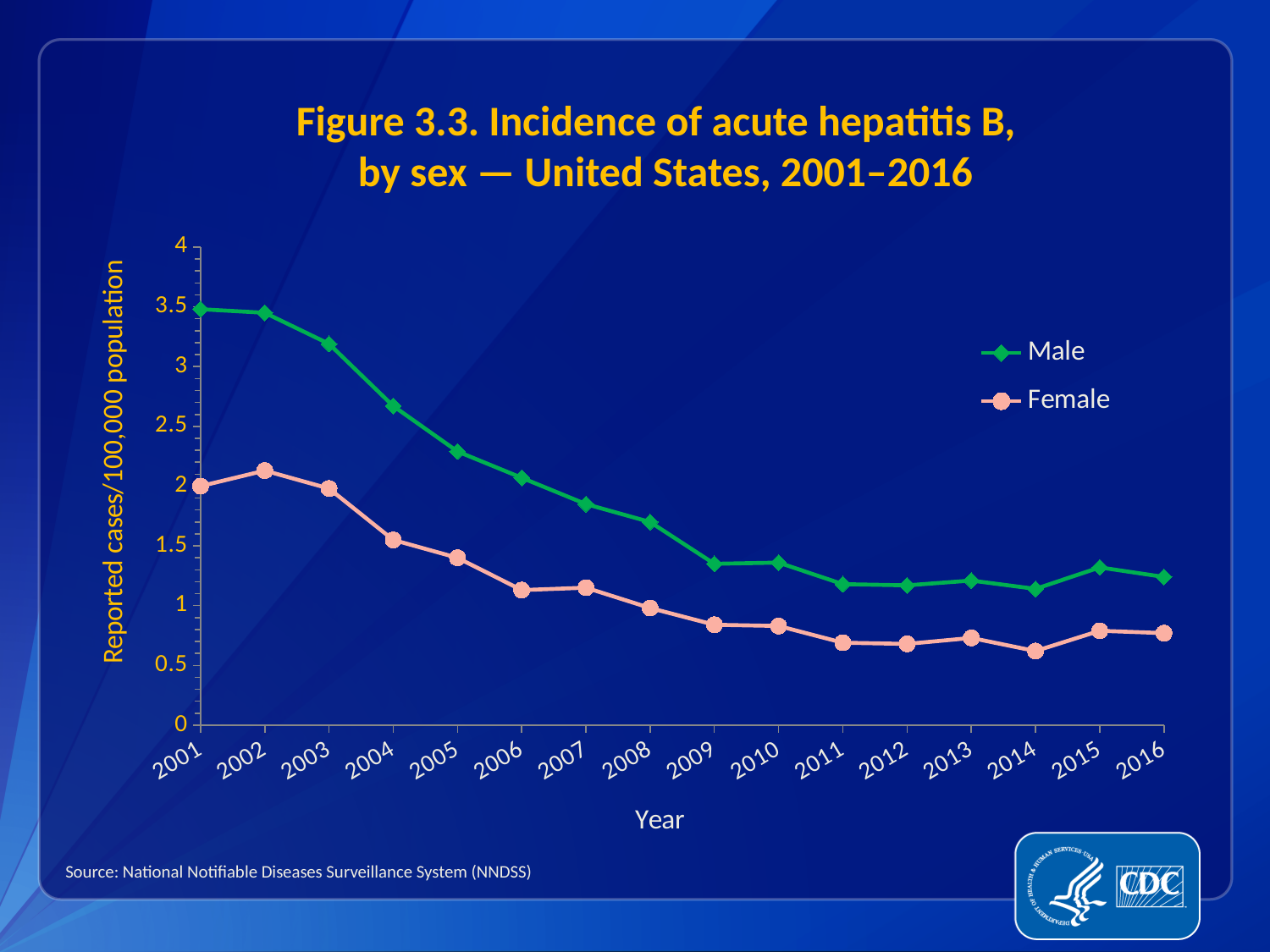
In 2005, which series has the higher incidence rate, Male or Female? Male How many series does the legend list? 2 Is the Male value for 2009 greater or less than 1.5? less Is the Male value for 2016 greater or less than 1? greater In which year is the Female incidence rate highest? 2002 In which year is the Female incidence rate lowest? 2014 Is the Male value for 2001 greater or less than 3? greater Does the Male incidence rate generally rise or fall from 2001 to 2016? fall How many years are plotted along the x axis? 16 What kind of chart is shown on the slide? line chart What is the label of the y axis? Reported cases/100,000 population